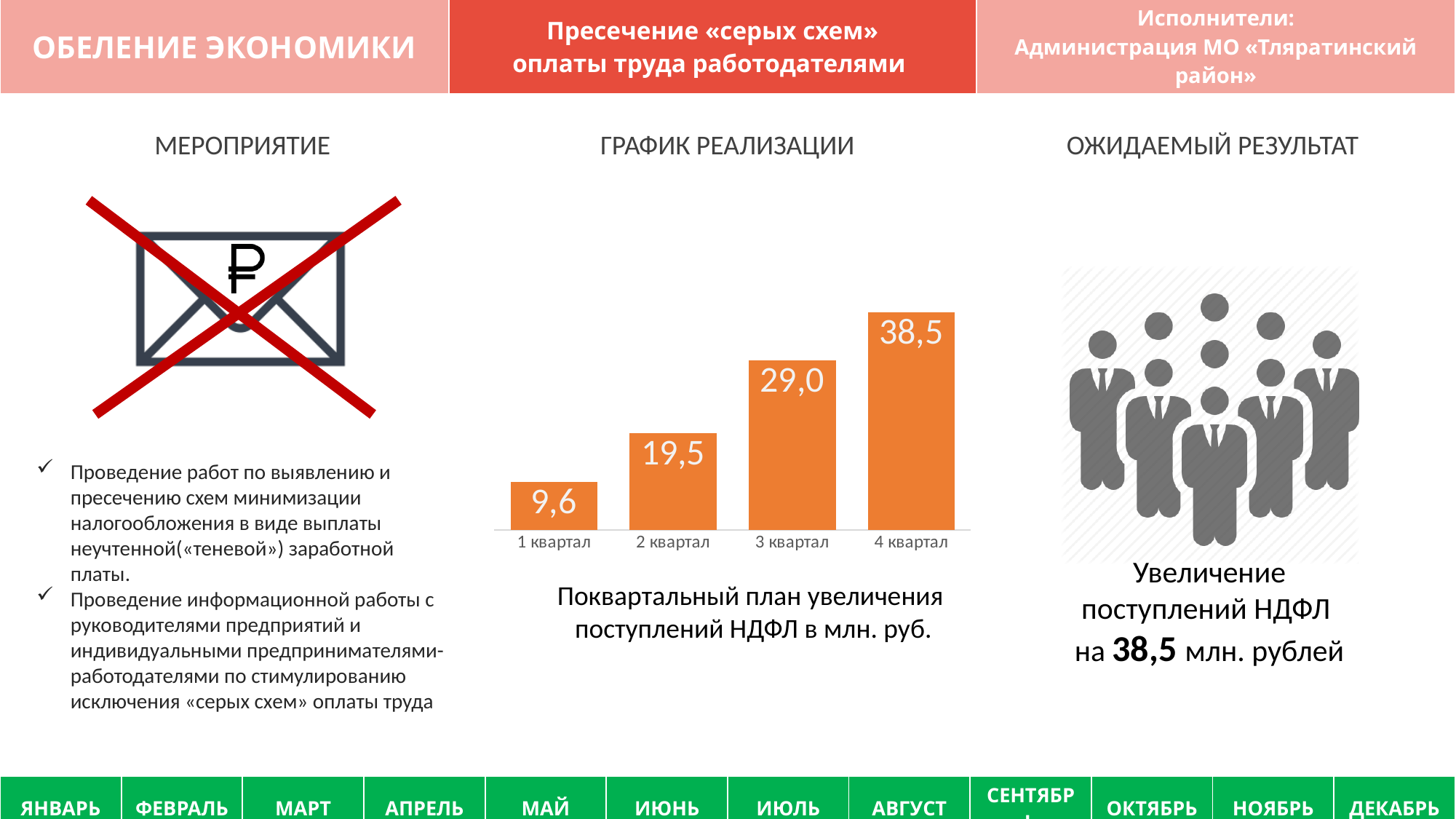
What is the value for 3 квартал? 29,0 What is the value for 2 квартал? 19,5 Which quarter has the highest value? 4 квартал What is the difference between the values for 3 квартал and 2 квартал? 9,5 How many categories are shown on the chart? 4 Which is larger, the value for 2 квартал or the value for 3 квартал? 3 квартал What is the value for 4 квартал? 38,5 Which quarter has the lowest value? 1 квартал Do the values rise or fall from 1 квартал to 4 квартал? rise What kind of chart is shown on the slide? bar chart What is the value for 1 квартал? 9,6 What is the difference between the values for 4 квартал and 1 квартал? 28,9